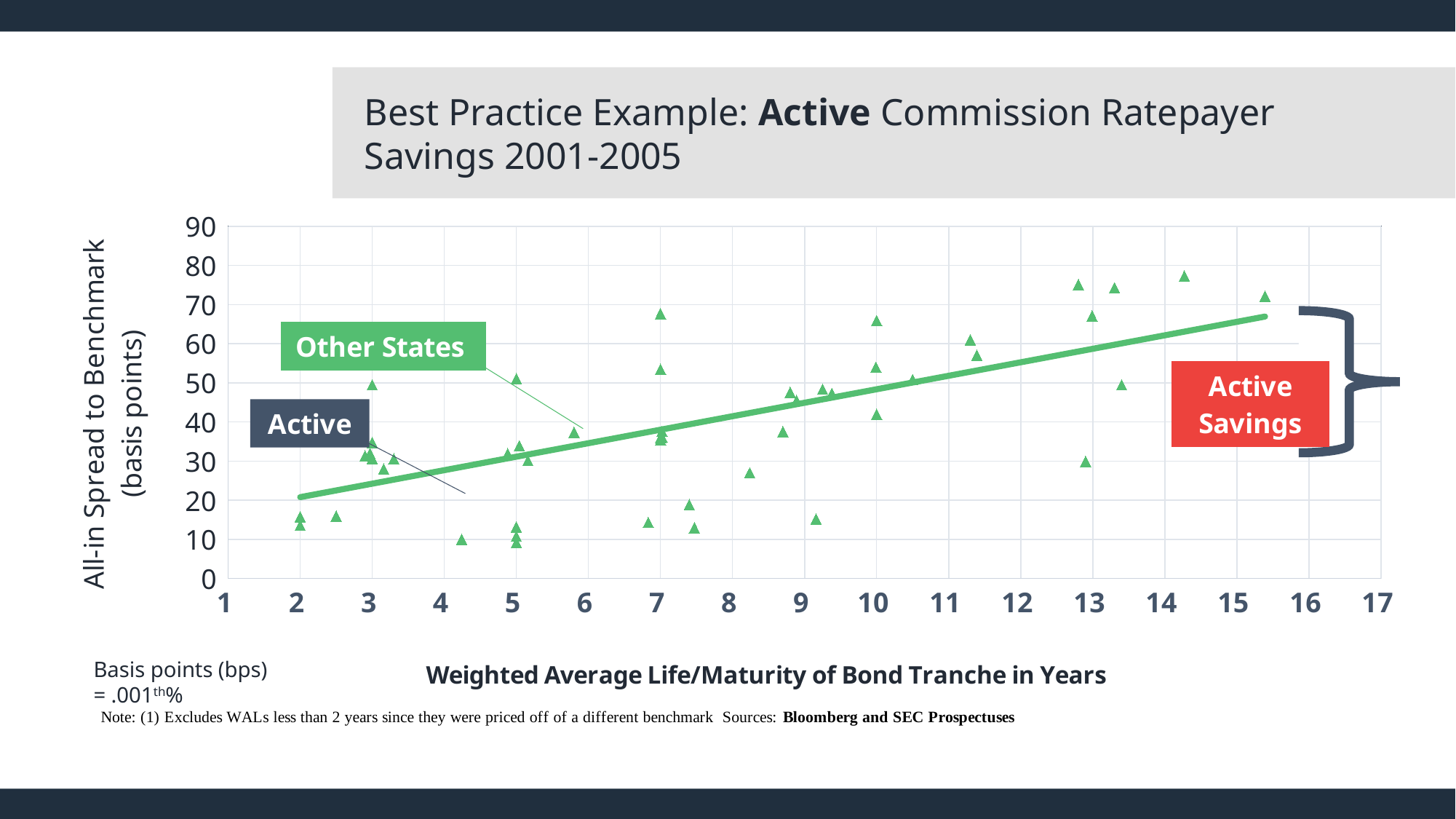
Does the green trend line rise or fall as the weighted average life in years increases? Rise Is the value of the highest plotted point near 7 years greater or less than 60 basis points? greater What is the label of the x axis of the chart? Weighted Average Life/Maturity of Bond Tranche in Years Is the value of the trend line at 15 years greater or less than 60 basis points? greater What kind of chart is shown on the slide? Scatter chart What is the maximum value shown on the y axis of the chart? 90 Is the value of the trend line at 2 years greater or less than 30 basis points? less